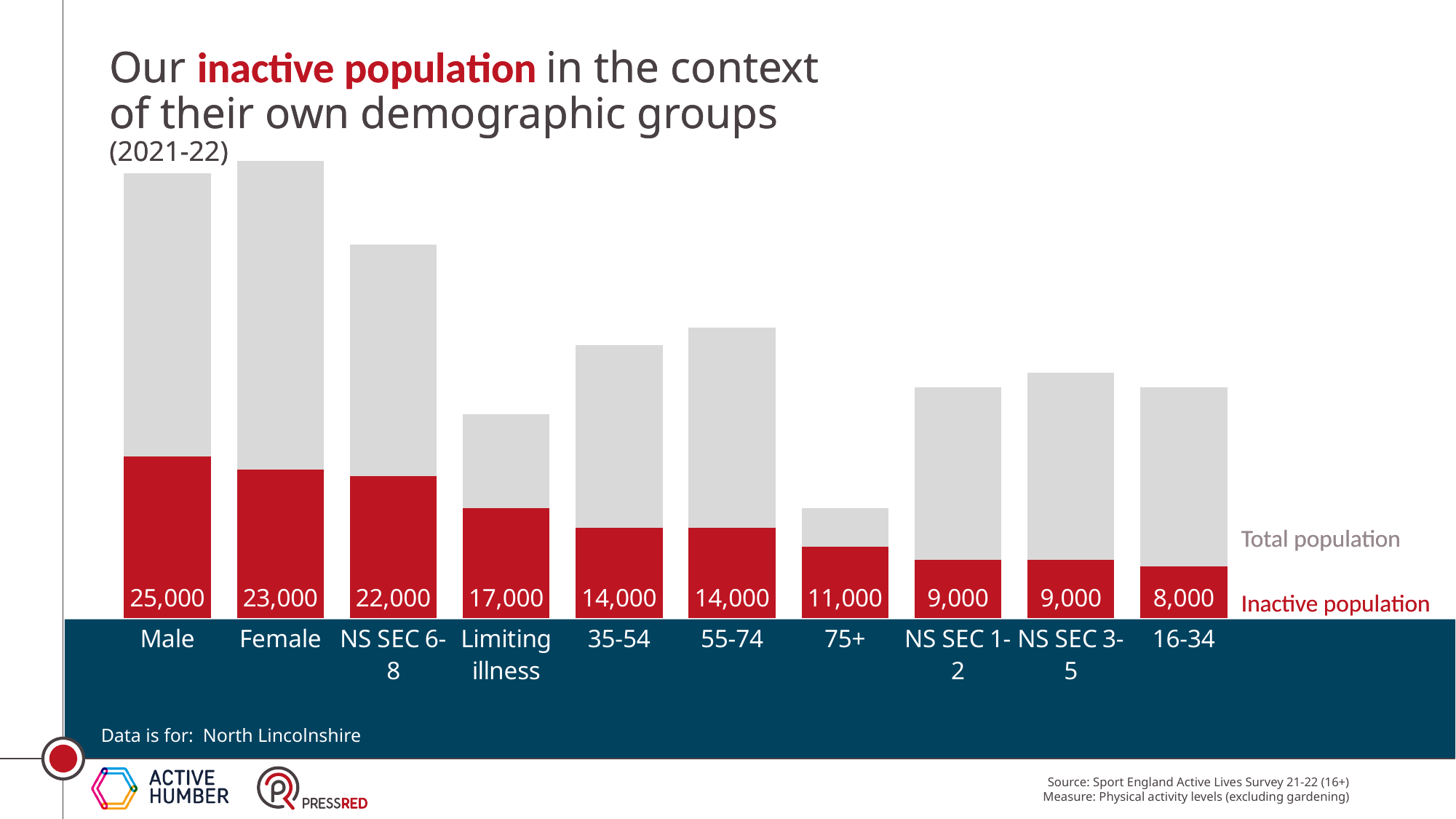
Do the inactive population values rise or fall from left to right across the chart? Fall Which has a larger inactive population, the 35-54 group or the 75+ group? 35-54 What is the difference between the inactive population of the Male group and the Female group? 2,000 What is the difference between the inactive population of the NS SEC 6-8 group and the NS SEC 1-2 group? 13,000 How many series does the chart's legend list? 2 What is the inactive population for the 75+ age group? 11,000 What is the inactive population for the Male group? 25,000 Which demographic group has the highest inactive population? Male Which demographic group has the lowest inactive population? 16-34 What kind of chart is shown on the slide? Bar chart How many demographic groups are shown on the chart? 10 What is the inactive population for the Limiting illness group? 17,000